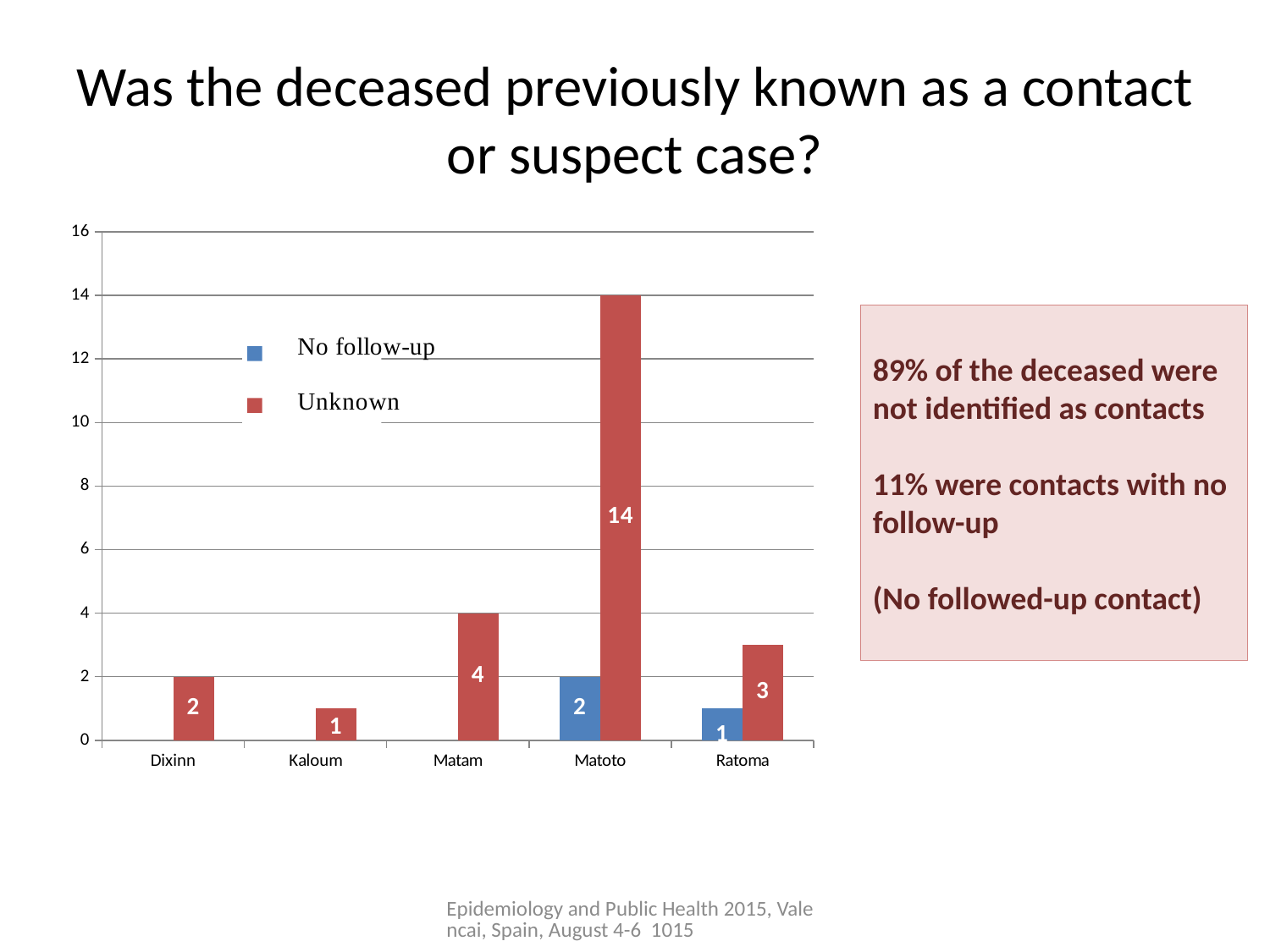
What kind of chart is shown on the slide? bar chart What is the Unknown value for Matoto? 14 How many series does the legend list? 2 Is the Unknown value for Matoto greater or less than 12? greater Which is larger, the Unknown value for Dixinn or the Unknown value for Matam? Matam What is the difference between the Unknown values for Matoto and Ratoma? 11 What is the No follow-up value for Ratoma? 1 Which category has the lowest Unknown value? Kaloum How many categories are shown on the x axis? 5 What is the Unknown value for Kaloum? 1 What is the Unknown value for Matam? 4 Which category has the highest Unknown value? Matoto